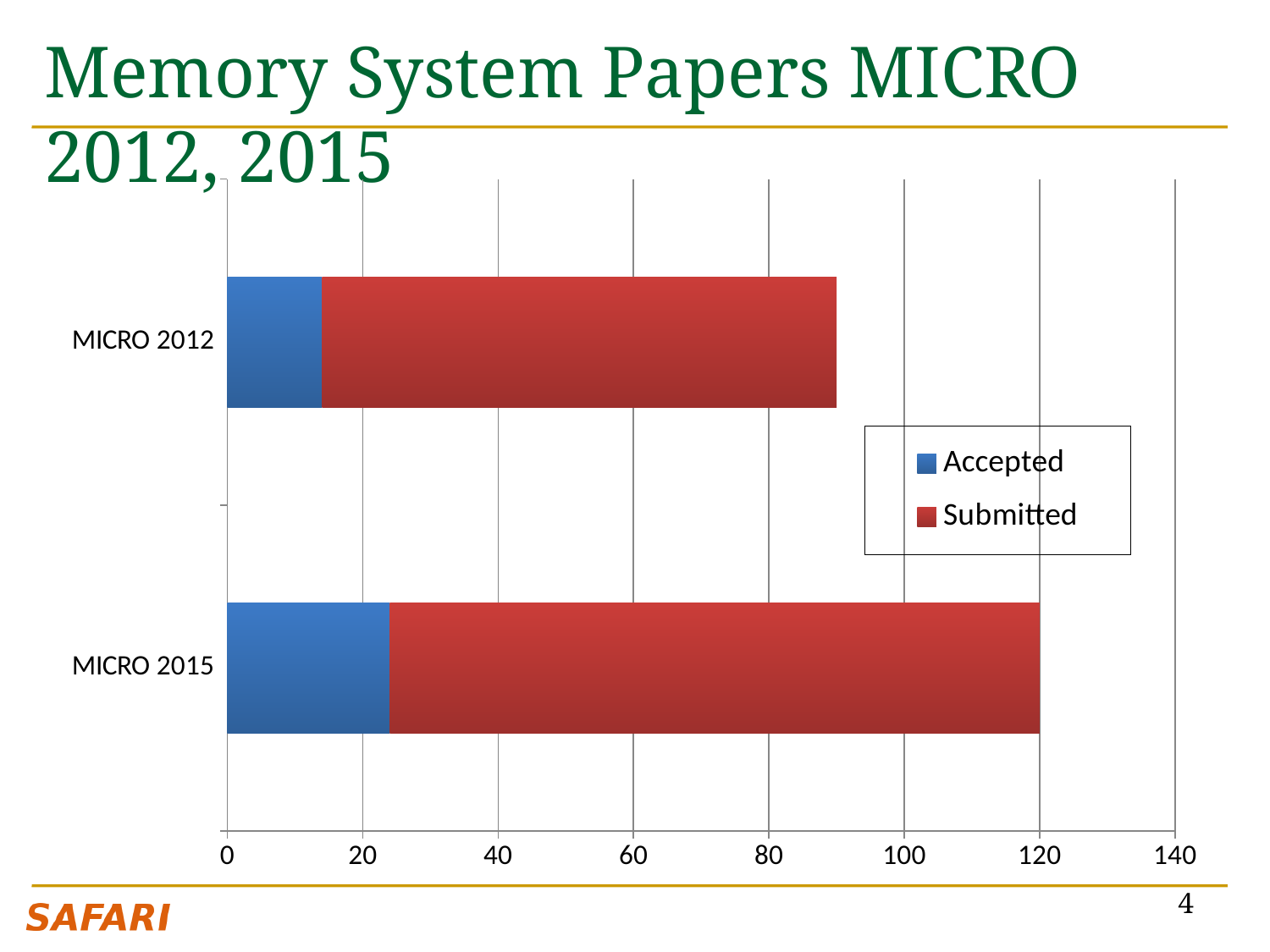
Is the total stacked value for MICRO 2015 greater or less than 100? greater How many categories are plotted on the chart? 2 Is the Accepted value for MICRO 2015 greater or less than 20? greater Is the total stacked value for MICRO 2012 greater or less than 100? less What is the highest value shown on the horizontal axis? 140 Which category has the longer total stacked bar, MICRO 2012 or MICRO 2015? MICRO 2015 For MICRO 2012, which series is larger, Accepted or Submitted? Submitted How many series does the legend list? 2 What colour represents the Accepted series in the legend? blue What kind of chart is shown on the slide? bar chart Which category has the larger Accepted value? MICRO 2015